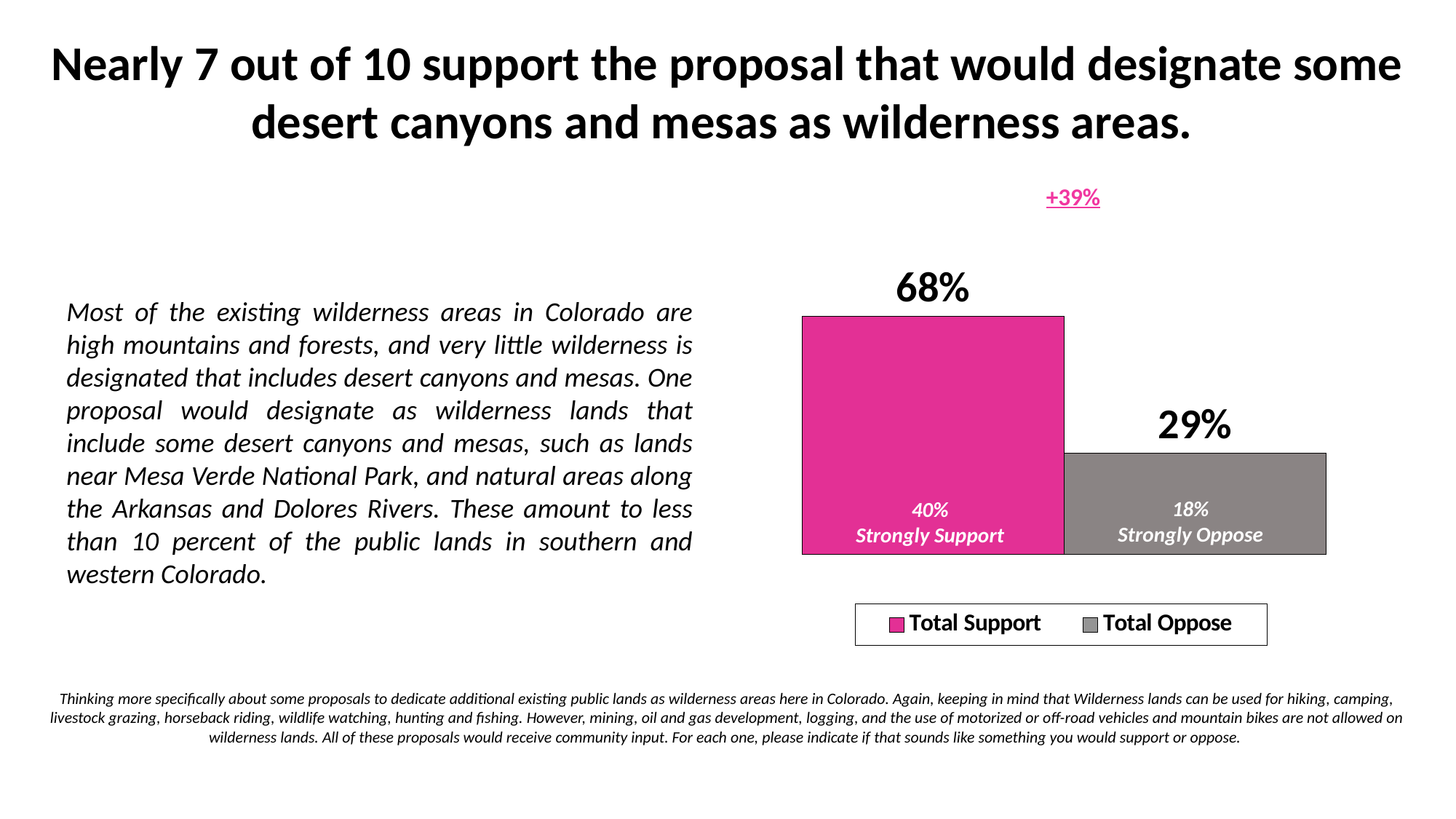
What is the difference between Strongly Support and Strongly Oppose? 22% Is Total Support larger than Total Oppose? Yes What percentage strongly support the proposal? 40% How many series does the legend list? 2 What is the difference between Total Support and Total Oppose? 39% What is the value for Total Oppose? 29% What percentage strongly oppose the proposal? 18% Which bar is lower, Total Support or Total Oppose? Total Oppose Which bar is higher, Total Support or Total Oppose? Total Support What kind of chart is shown on the slide? Bar chart How many bars are shown in the chart? 2 What is the value for Total Support? 68%